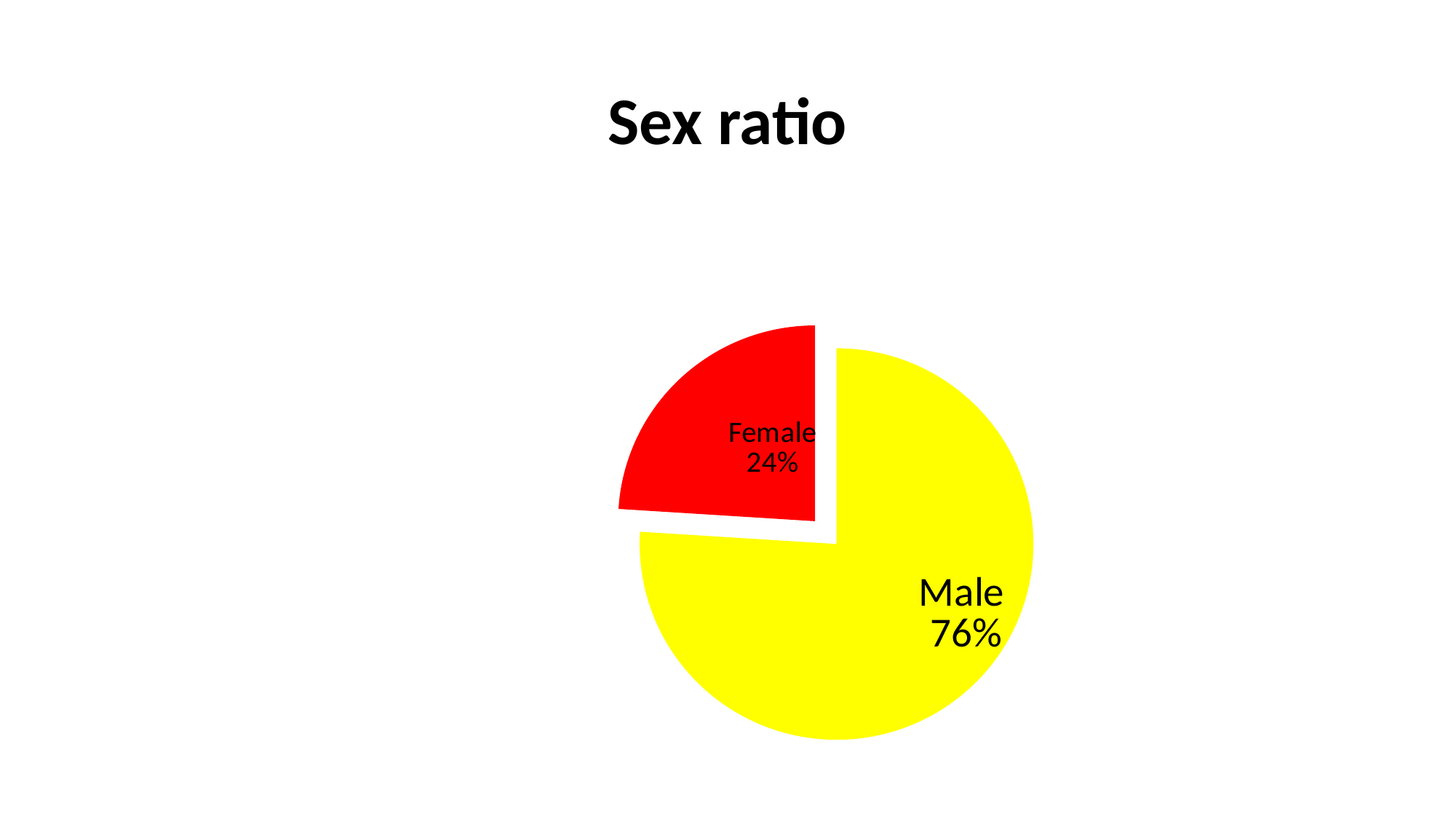
What is the title of the chart? Sex ratio What percentage of the pie is Male? 76% Which slice is the largest? Male What kind of chart is shown on the slide? pie chart How many slices does the pie chart have? 2 What share of the pie does the Female slice represent? 24% What is the difference in percentage points between the Male and Female slices? 52 What percentage of the pie is Female? 24% Which slice is the smallest? Female What colour is the Female slice? red Which is larger, the Male slice or the Female slice? Male